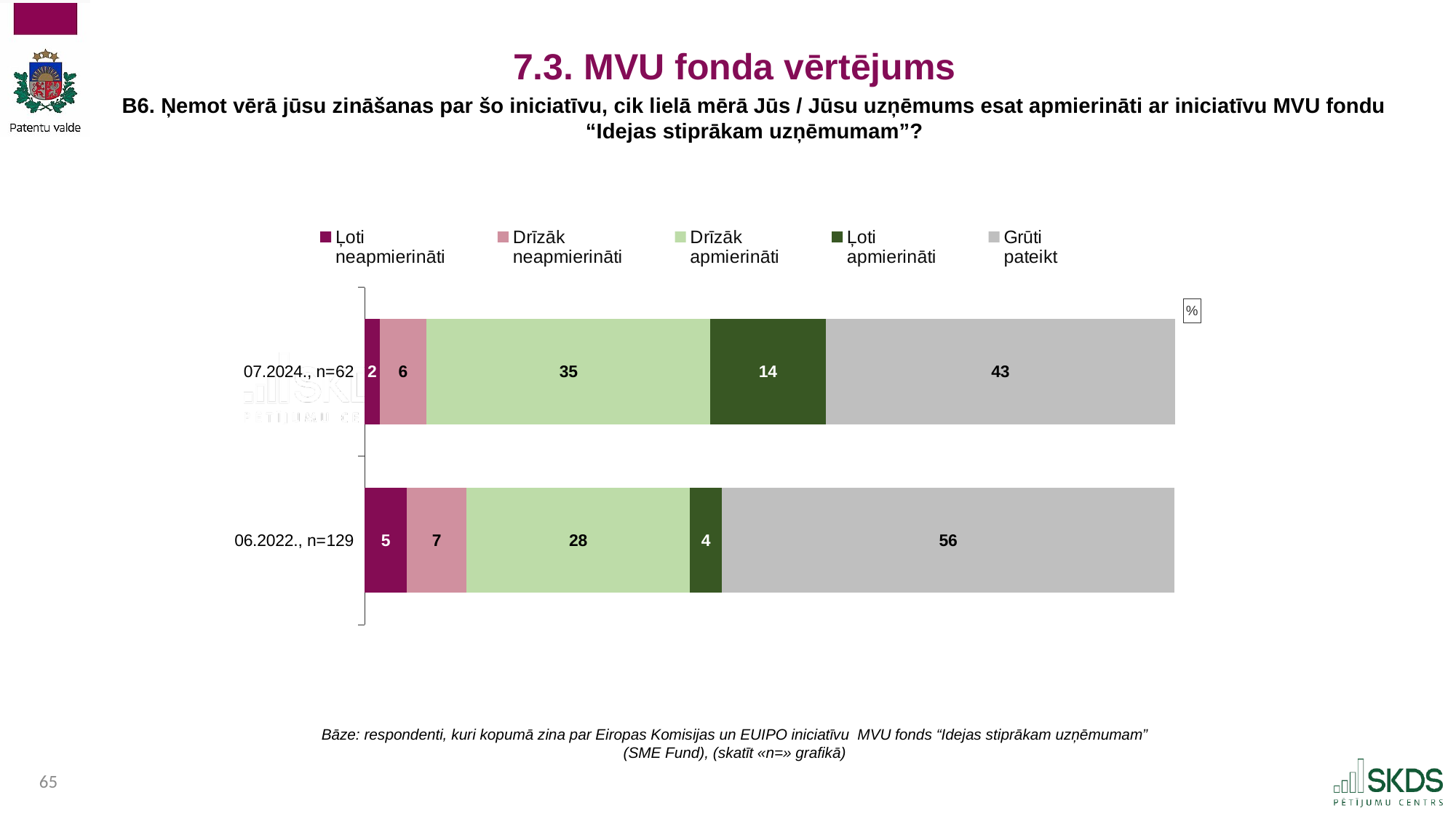
What is the difference between the "Grūti pateikt" values for 06.2022., n=129 and 07.2024., n=62? 13 What is the value for "Grūti pateikt" in the 07.2024., n=62 bar? 43 What kind of chart is shown on the slide? Stacked bar chart Which segment is the largest in the 06.2022., n=129 bar? Grūti pateikt Which segment is the smallest in the 07.2024., n=62 bar? Ļoti neapmierināti How many series does the legend list? 5 How many bars (survey waves) are shown in the chart? 2 What is the value for "Ļoti apmierināti" in the 07.2024., n=62 bar? 14 Which is larger: "Ļoti apmierināti" in 07.2024., n=62 or in 06.2022., n=129? 07.2024., n=62 What is the total of the 07.2024., n=62 bar? 100 What is the value for "Drīzāk apmierināti" in the 06.2022., n=129 bar? 28 What is the value for "Ļoti neapmierināti" in the 06.2022., n=129 bar? 5